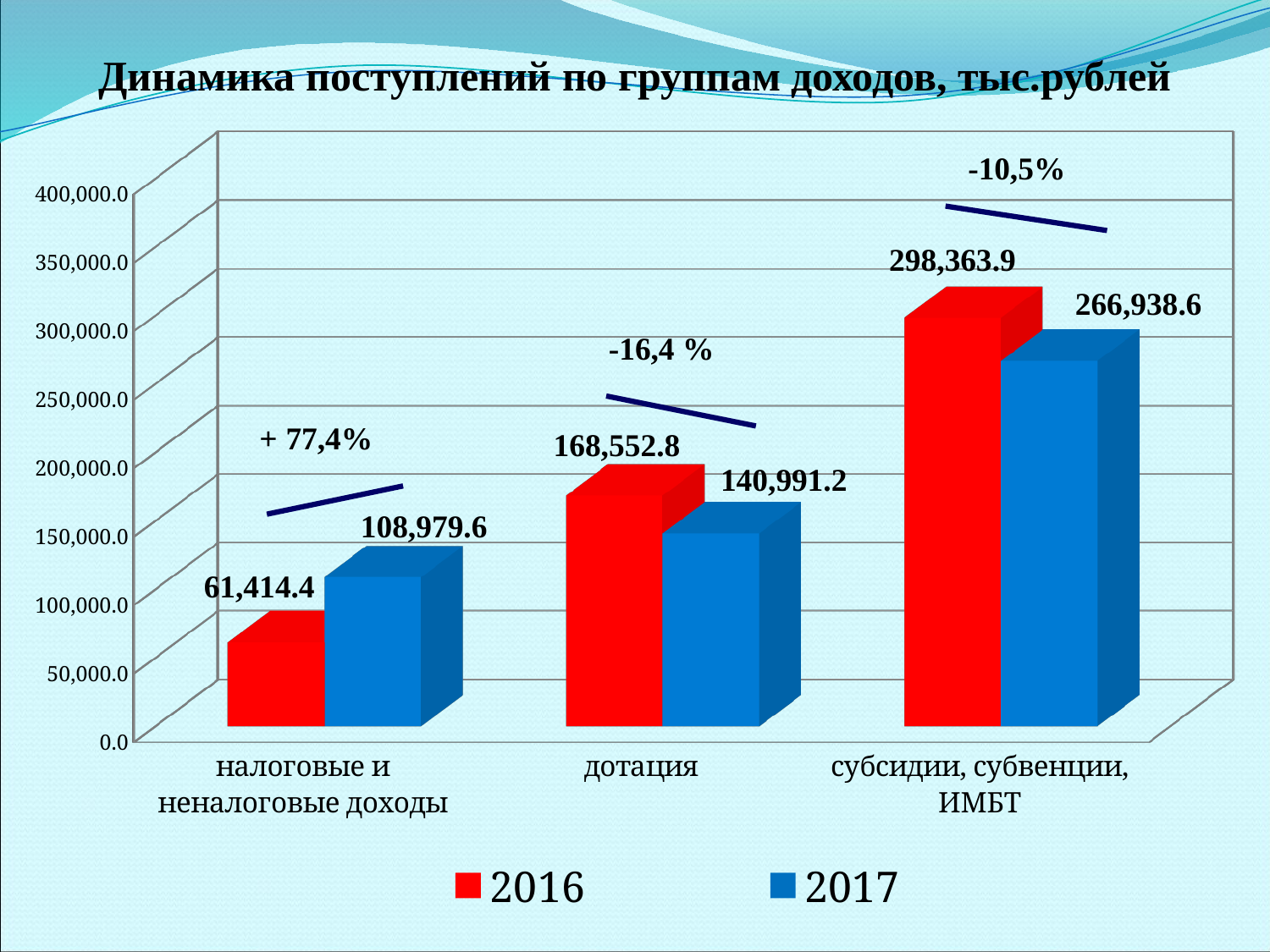
How many series does the legend list? 2 Which category has the highest 2016 value? субсидии, субвенции, ИМБТ What is the difference between the 2017 and 2016 values for налоговые и неналоговые доходы? 47,565.2 What is the 2017 value for субсидии, субвенции, ИМБТ? 266,938.6 What kind of chart is shown on the slide? bar chart Which is larger for субсидии, субвенции, ИМБТ: the 2016 value or the 2017 value? 2016 What is the difference between the 2016 and 2017 values for дотация? 27,561.6 How many categories are shown on the x axis? 3 What is the 2017 value for дотация? 140,991.2 What is the 2016 value for налоговые и неналоговые доходы? 61,414.4 What percentage change is annotated above the дотация bars? -16,4 % Which category has the lowest 2017 value? налоговые и неналоговые доходы